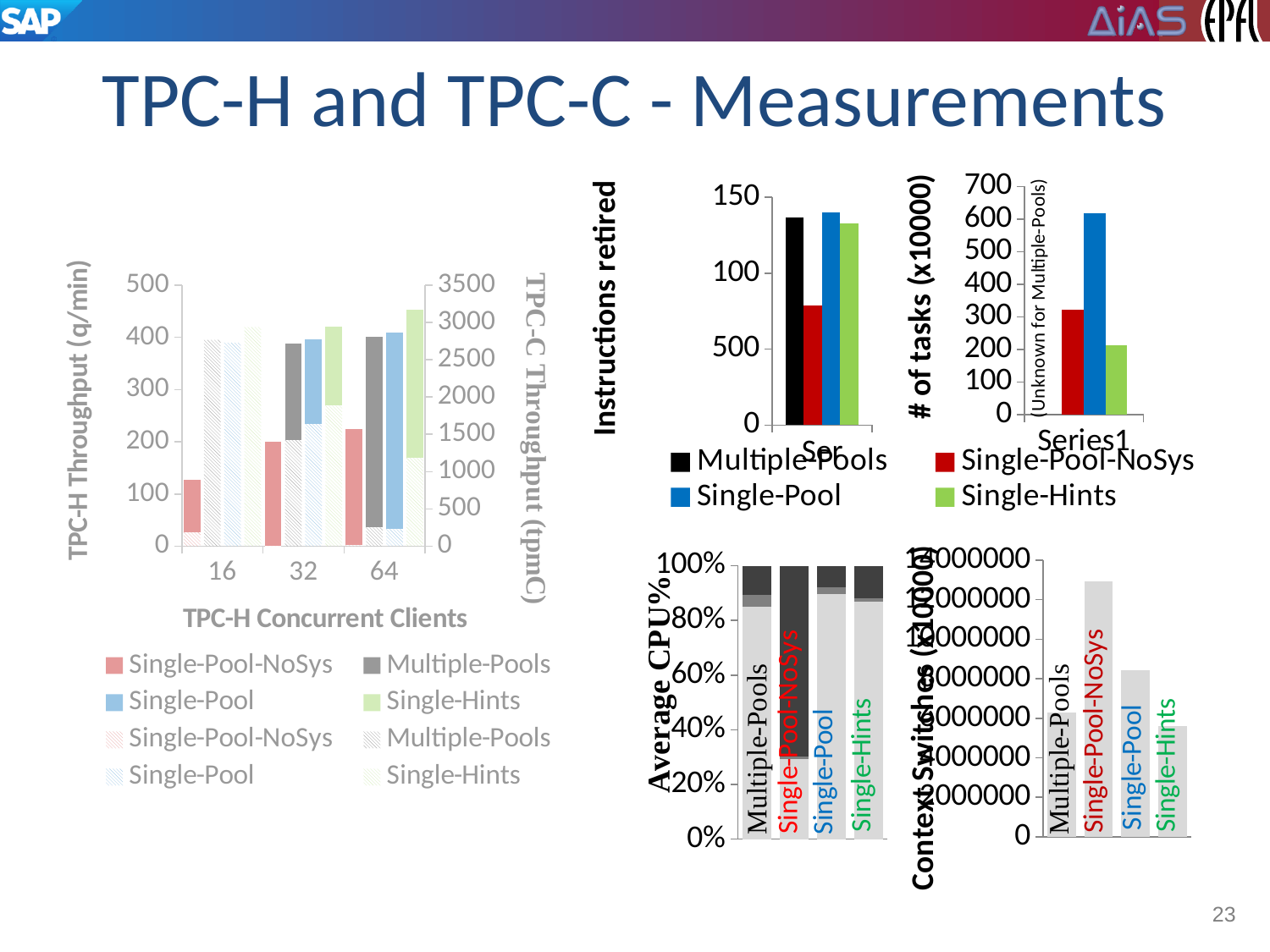
In the Context Switches (x1000) chart, which configuration has the highest value? Single-Pool-NoSys In the Instructions retired chart, is the value for Multiple-Pools greater or less than 100? greater In the # of tasks (x10000) chart, which configuration has the lowest plotted value? Single-Hints In the # of tasks (x10000) chart, which configuration has the highest value? Single-Pool In the Instructions retired chart, which configuration has the lowest value? Single-Pool-NoSys In the Context Switches (x1000) chart, is the value for Multiple-Pools greater or less than 6000000? less In the TPC-H/TPC-C throughput chart on the left, how many entries does the legend list? 8 In the TPC-H/TPC-C throughput chart on the left, is the TPC-H throughput for Single-Pool-NoSys at 16 concurrent clients greater or less than 200? less What kind of chart is the Average CPU% chart? Stacked bar chart In the TPC-H/TPC-C throughput chart on the left, how many values of TPC-H Concurrent Clients are shown on the x axis? 3